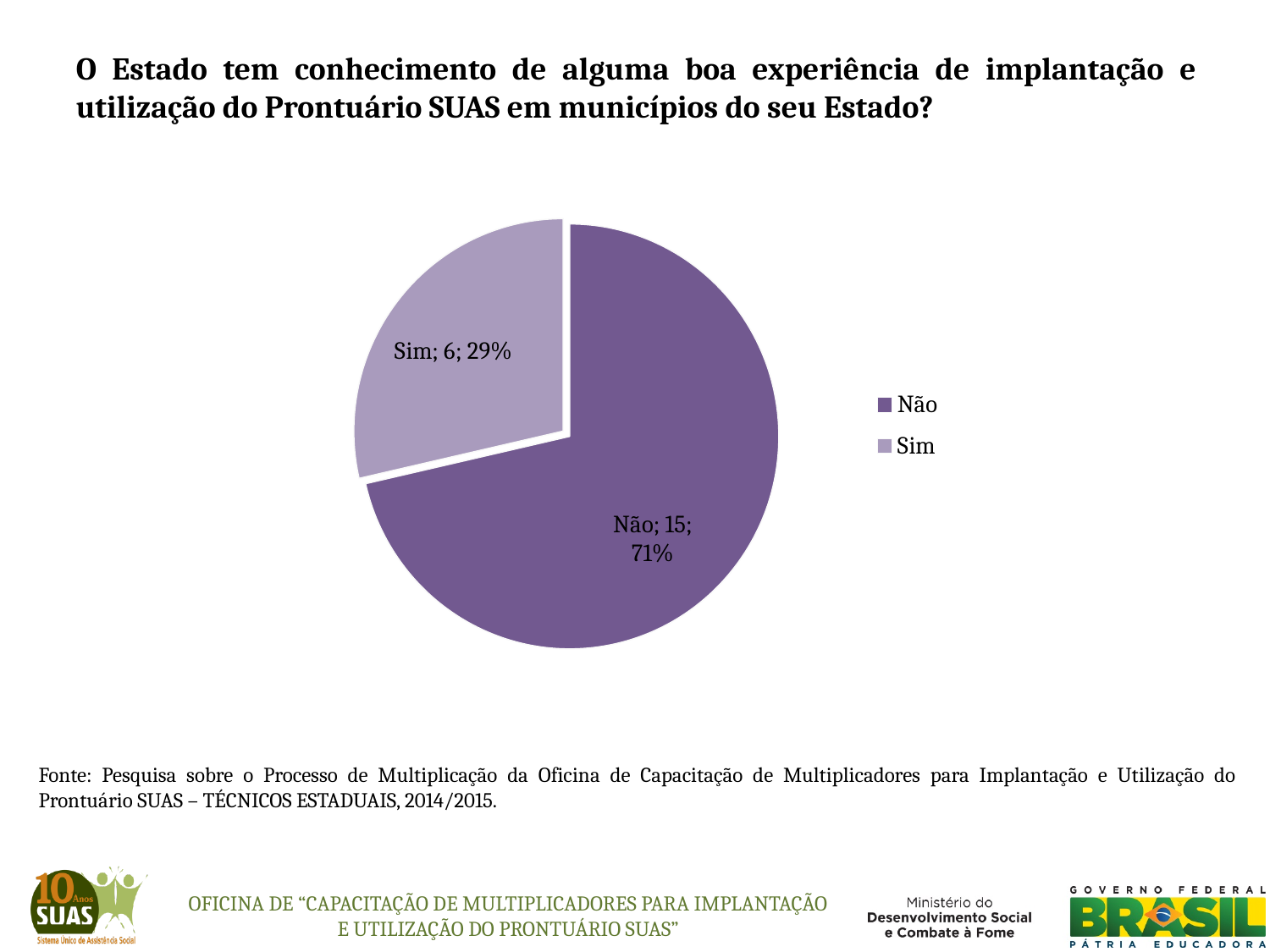
What is the total number of responses shown in the pie chart? 21 Which is larger, the count for "Não" or the count for "Sim"? Não How many respondents answered "Sim"? 6 What kind of chart is shown on the slide? pie chart What percentage of the pie does the "Sim" slice represent? 29% What percentage of the pie does the "Não" slice represent? 71% How many categories does the pie chart have? 2 Which legend entry is shown with the lighter purple colour? Sim Which category has the smallest slice of the pie? Sim Which category has the largest slice of the pie? Não What is the difference between the number of "Não" and "Sim" responses? 9 How many respondents answered "Não"? 15